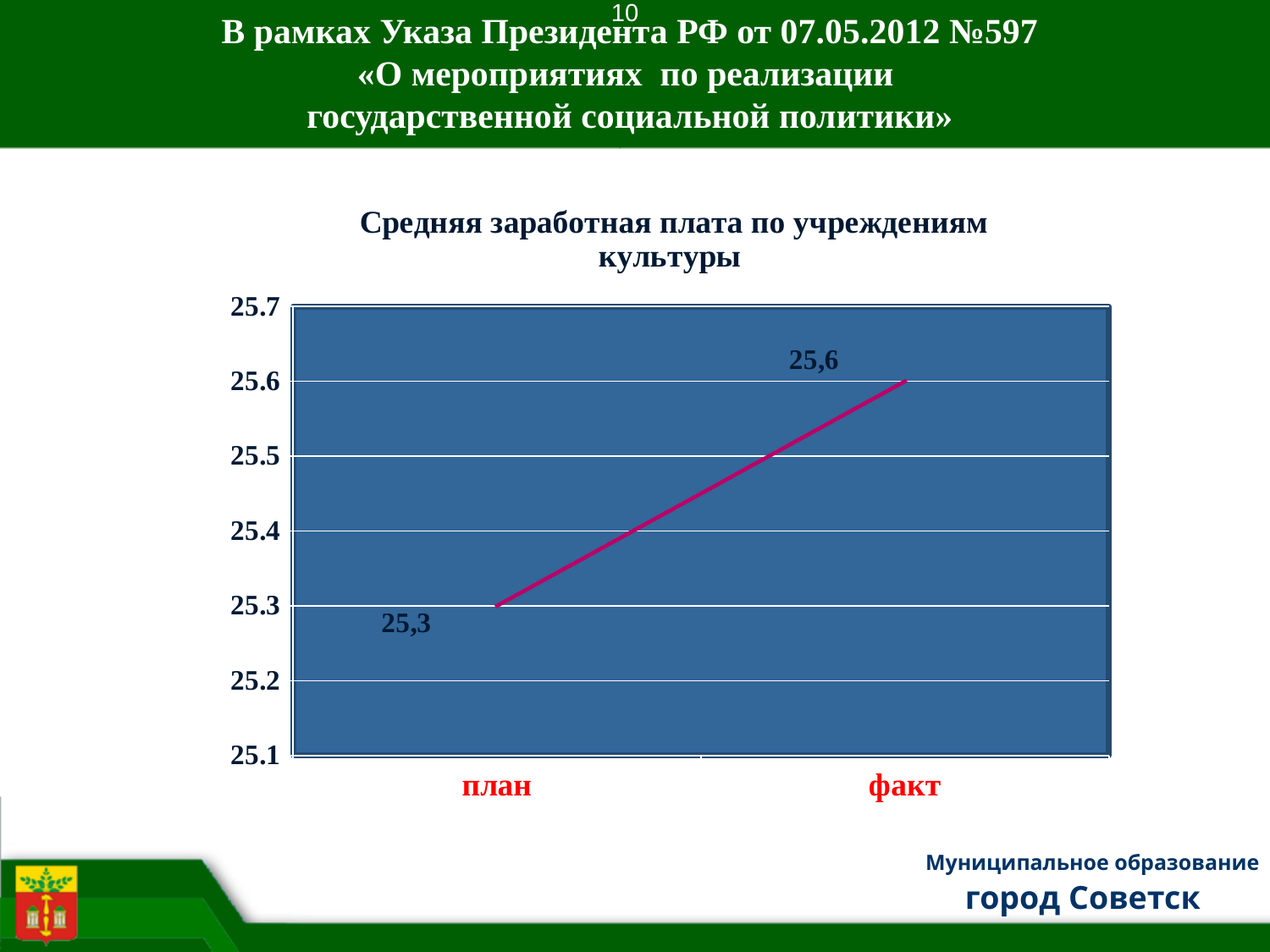
What is the title of the chart? Средняя заработная плата по учреждениям культуры What is the value for факт? 25,6 Is the value for факт greater or less than 25.5? greater Which category has the higher value, план or факт? факт How many categories are shown on the x axis? 2 Which category has the lowest value? план Do the values rise or fall from план to факт? rise Is the value for план greater or less than 25.4? less What kind of chart is shown on the slide? line chart Which category has the highest value? факт What is the value for план? 25,3 What is the difference between the values for факт and план? 0,3